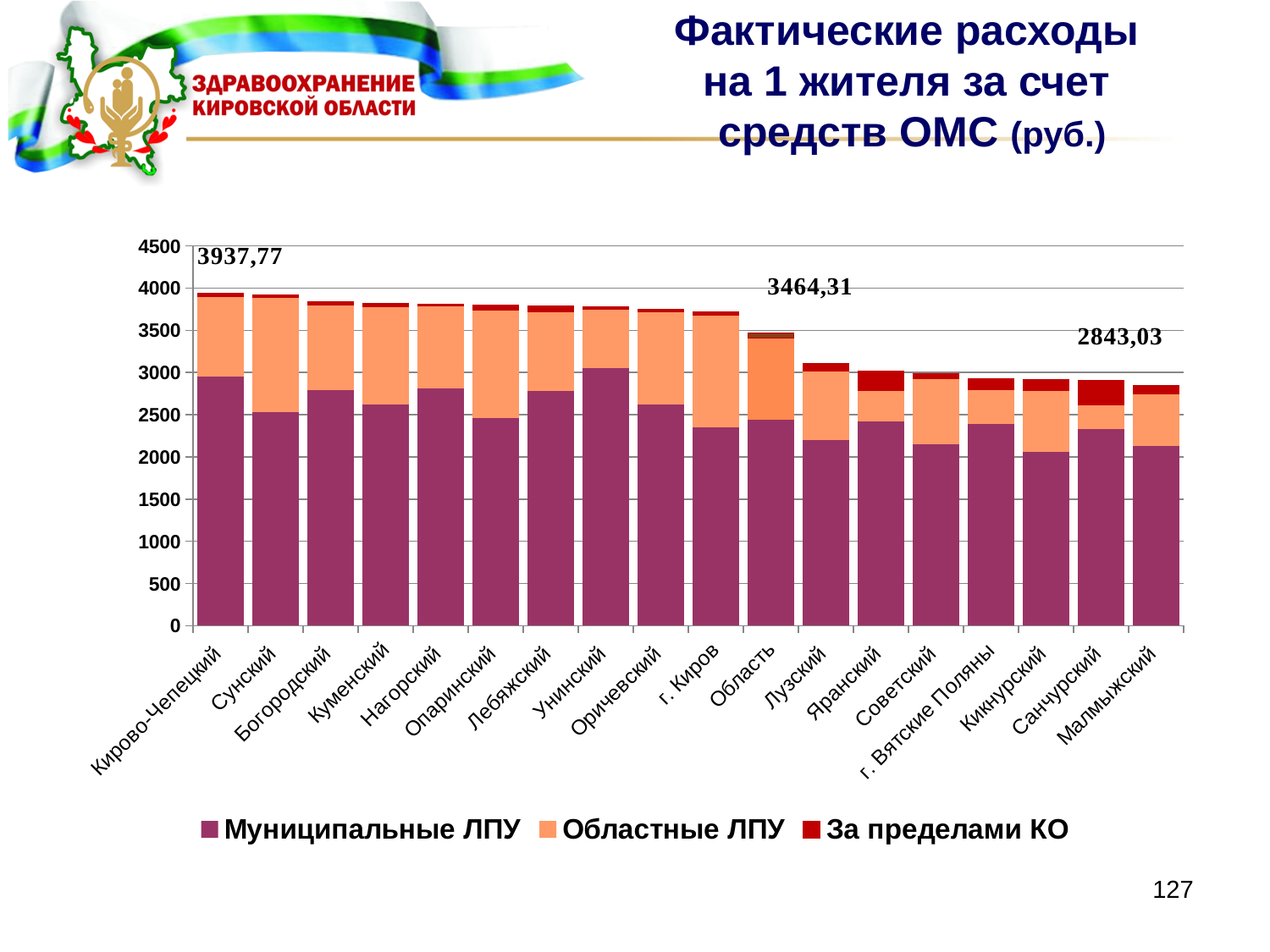
What kind of chart is shown on the slide? Stacked bar chart Which category has the highest total bar? Кирово-Чепецкий Is the total value for Лузский greater or less than 3500? less How many series does the legend list? 3 What is the total value labelled for Кирово-Чепецкий? 3937,77 What is the difference between the labelled totals for Кирово-Чепецкий and Малмыжский? 1094,74 What is the total value labelled for Малмыжский? 2843,03 Do the total bar values rise or fall from left to right along the x axis? fall What is the total value labelled for Область? 3464,31 How many categories (territories) are shown on the x axis? 18 Which series is shown in dark purple in the legend? Муниципальные ЛПУ Which category has the lowest total bar? Малмыжский